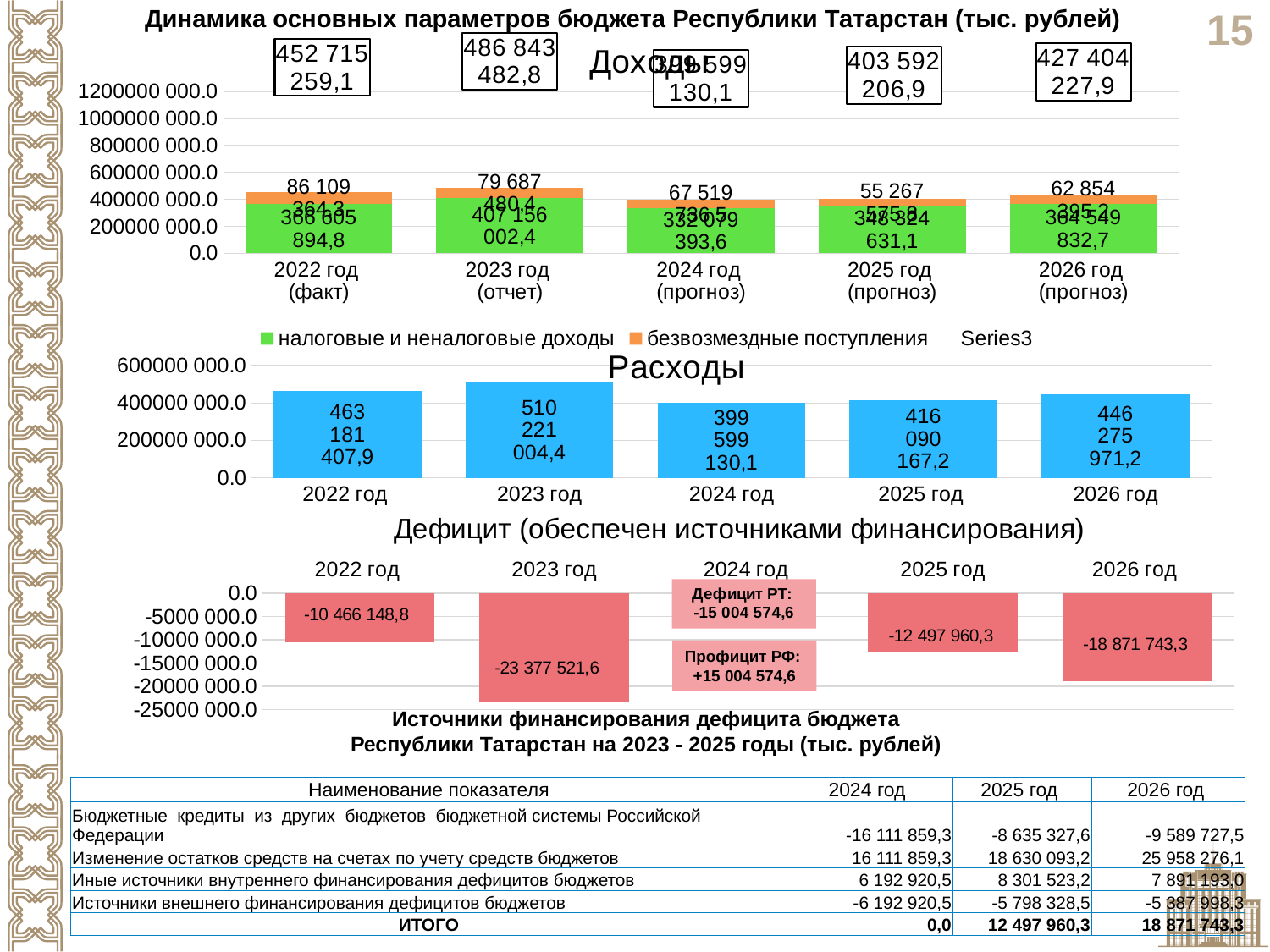
In the Дефицит chart, what is the value for 2023 год? -23 377 521,6 In the Расходы chart, which is larger: the value for 2025 год or 2026 год? 2026 год What kind of chart is the Доходы chart? Stacked bar chart In the Расходы chart, which year has the lowest value? 2024 год How many series does the legend of the Доходы chart list? 3 In the Доходы chart, which year has the highest total income? 2023 год (отчет) In the Дефицит chart, what is the value for 2025 год? -12 497 960,3 In the Расходы chart, which year has the highest value? 2023 год In the Расходы chart, what is the value for 2023 год? 510 221 004,4 In the Доходы chart, what is the total value shown above the bar for 2026 год (прогноз)? 427 404 227,9 In the Доходы chart, what is the total value shown above the bar for 2022 год (факт)? 452 715 259,1 In the Расходы chart, what is the difference between the values for 2023 год and 2022 год? 47 039 596,5